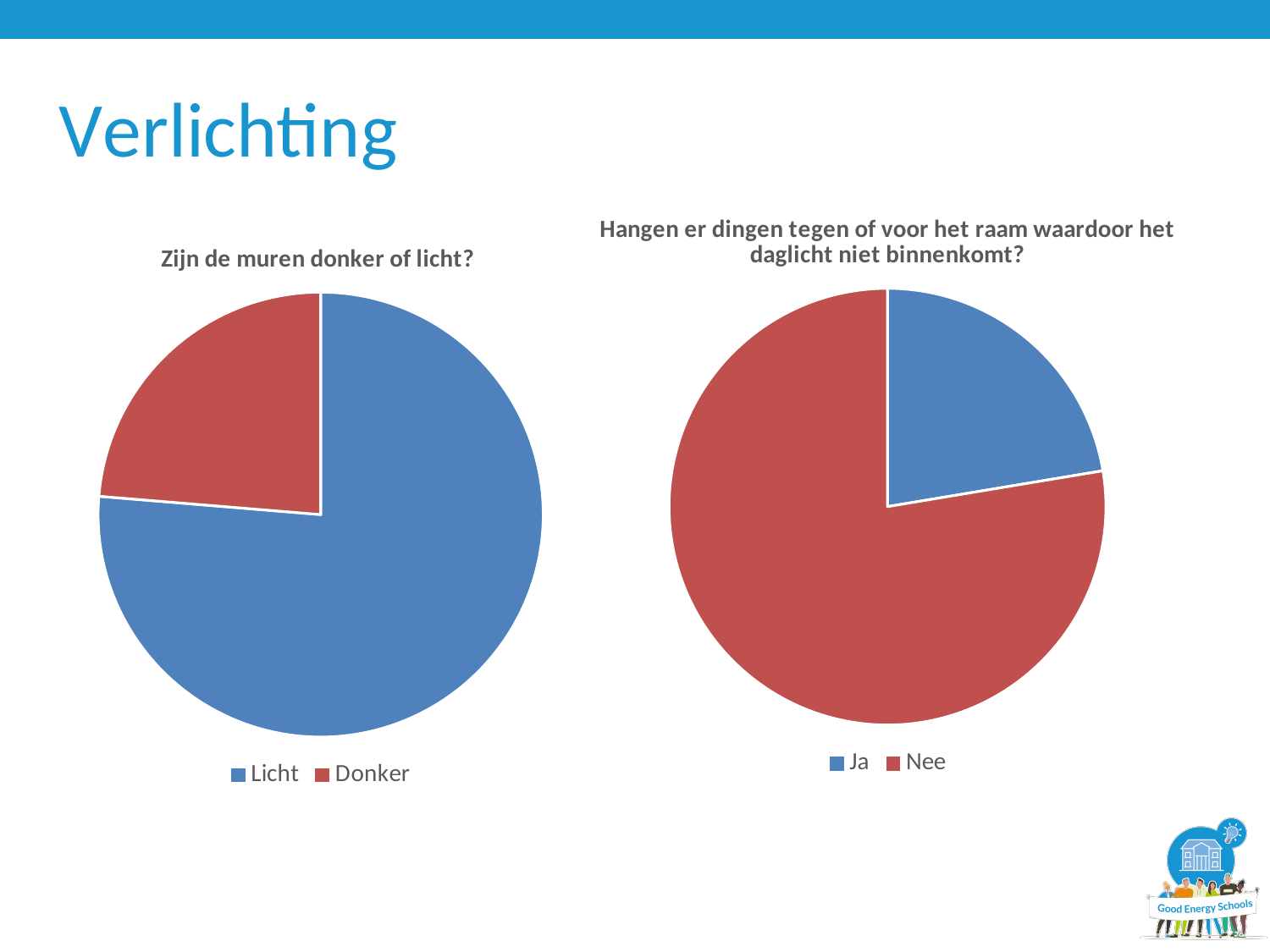
How many entries does the legend of the chart on the right list? 2 How many slices does the chart titled "Zijn de muren donker of licht?" have? 2 In the chart on the right, which category has the smallest slice? Ja In the chart on the right, which category has the largest slice? Nee In the chart titled "Zijn de muren donker of licht?", what colour is the Donker slice? red What kind of chart is the chart titled "Zijn de muren donker of licht?"? pie chart What is the title of the chart on the right of the slide? Hangen er dingen tegen of voor het raam waardoor het daglicht niet binnenkomt? In the chart titled "Zijn de muren donker of licht?", which is larger, Licht or Donker? Licht What kind of chart is the chart on the right of the slide? pie chart In the chart titled "Zijn de muren donker of licht?", which category has the largest slice? Licht In the chart on the right, which is larger, Ja or Nee? Nee In the chart titled "Zijn de muren donker of licht?", which category has the smallest slice? Donker